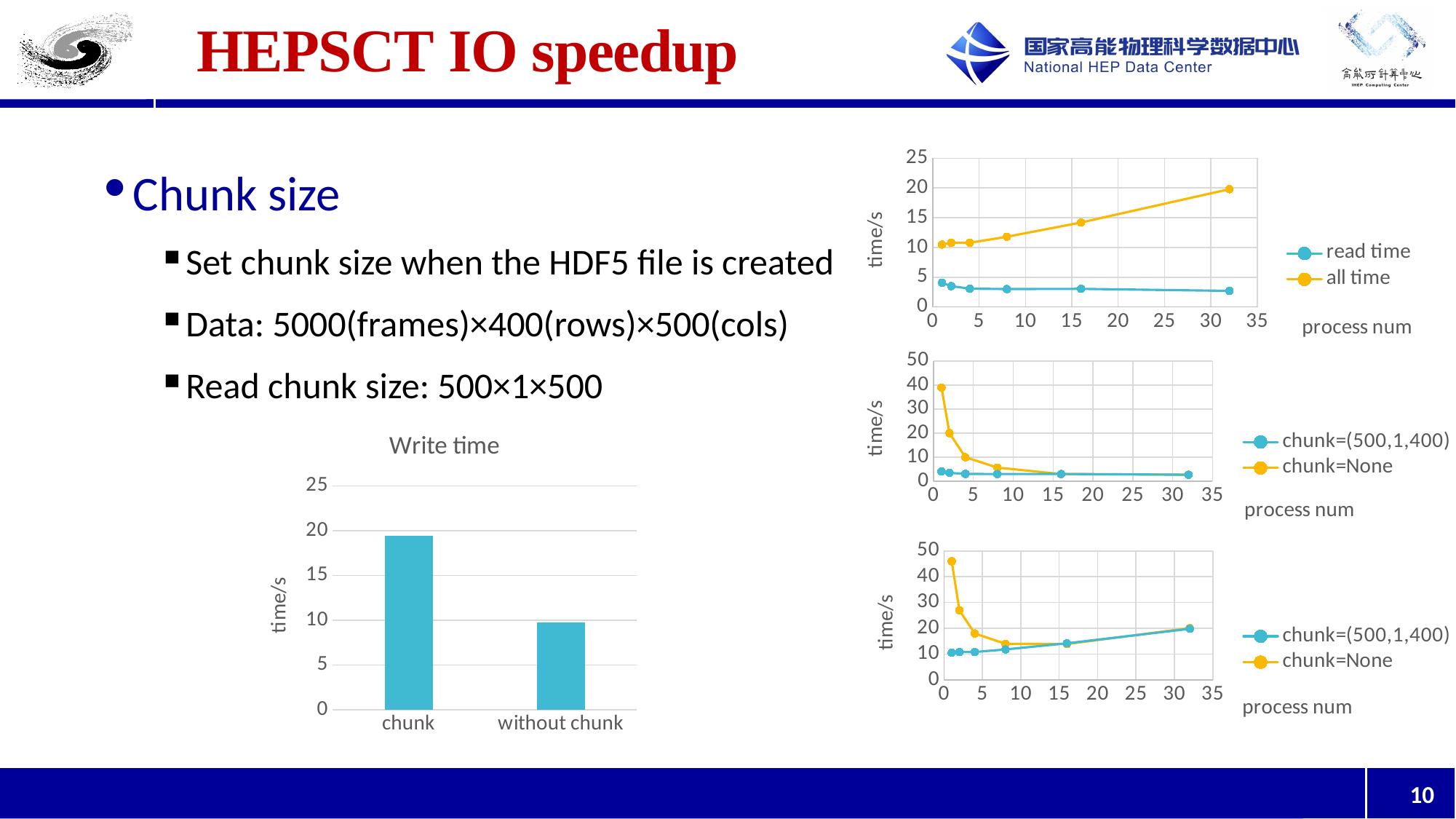
In the top right line chart, is the read time value at process num 32 greater or less than 5? less In the middle right line chart, does the chunk=None series rise or fall as process num increases? fall In the "Write time" chart, how many categories are shown? 2 In the top right line chart, does the all time series rise or fall as process num increases? rise In the middle right line chart, is the chunk=None value at process num 1 greater or less than 30? greater In the top right line chart, is the all time value at process num 32 greater or less than 15? greater What kind of chart is the "Write time" chart? bar chart In the top right line chart, how many series does the legend list? 2 In the bottom right line chart, which series has the higher value at process num 1, chunk=(500,1,400) or chunk=None? chunk=None In the "Write time" chart, which category has the higher write time, chunk or without chunk? chunk